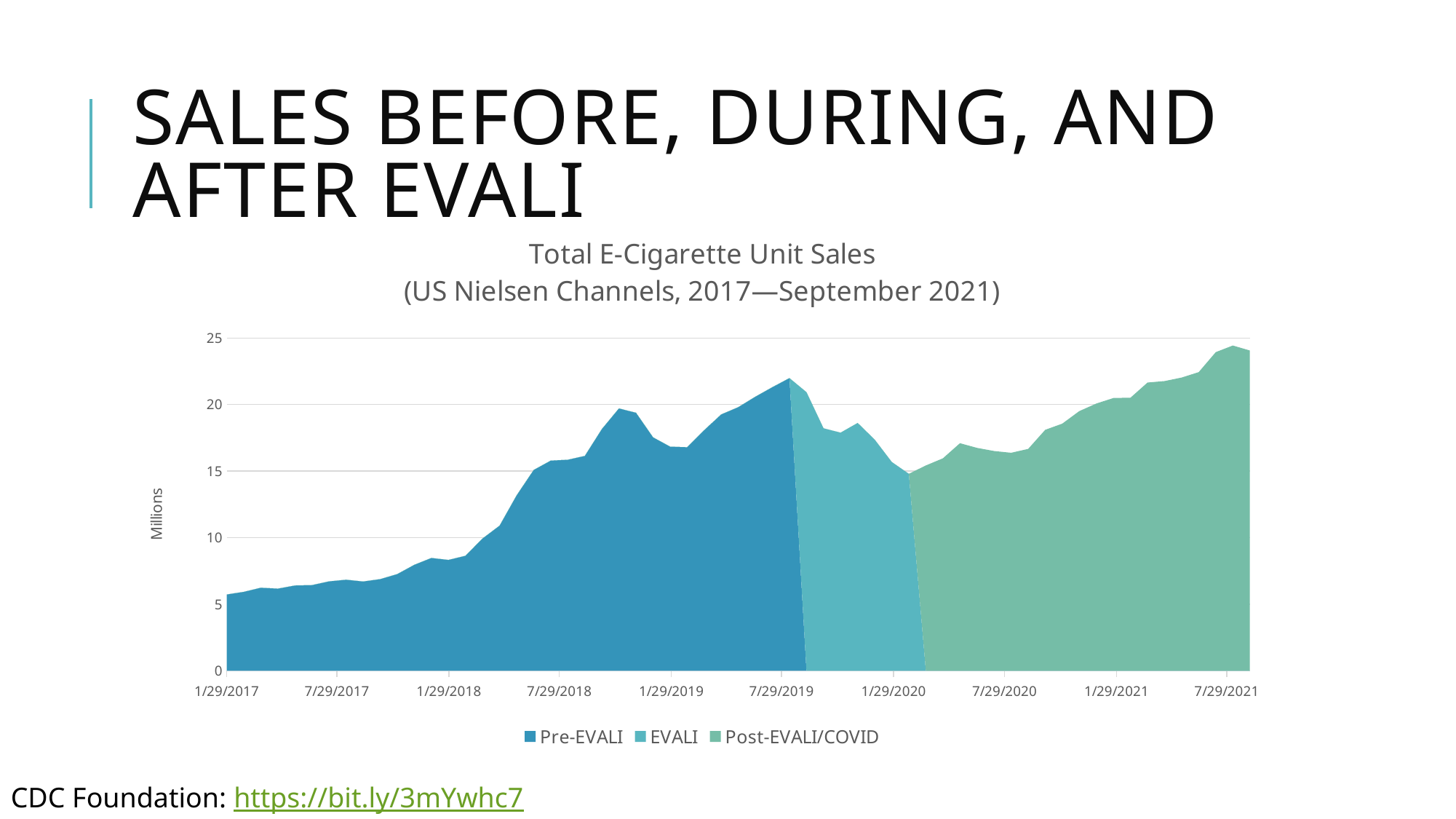
What are the three series named in the legend? Pre-EVALI, EVALI, Post-EVALI/COVID Do the values in the Pre-EVALI period generally rise or fall from 1/29/2017 to 7/29/2019? rise What is the title of the chart? Total E-Cigarette Unit Sales (US Nielsen Channels, 2017—September 2021) Is the value at 7/29/2021 greater or less than 20? greater Is the value at 7/29/2020 greater or less than 15? greater How many series does the legend list? 3 What kind of chart is shown on the slide? Area chart Is the value at 1/29/2018 greater or less than 10? less Which series reaches the highest peak value on the chart? Post-EVALI/COVID Do the values in the EVALI period generally rise or fall over time? fall